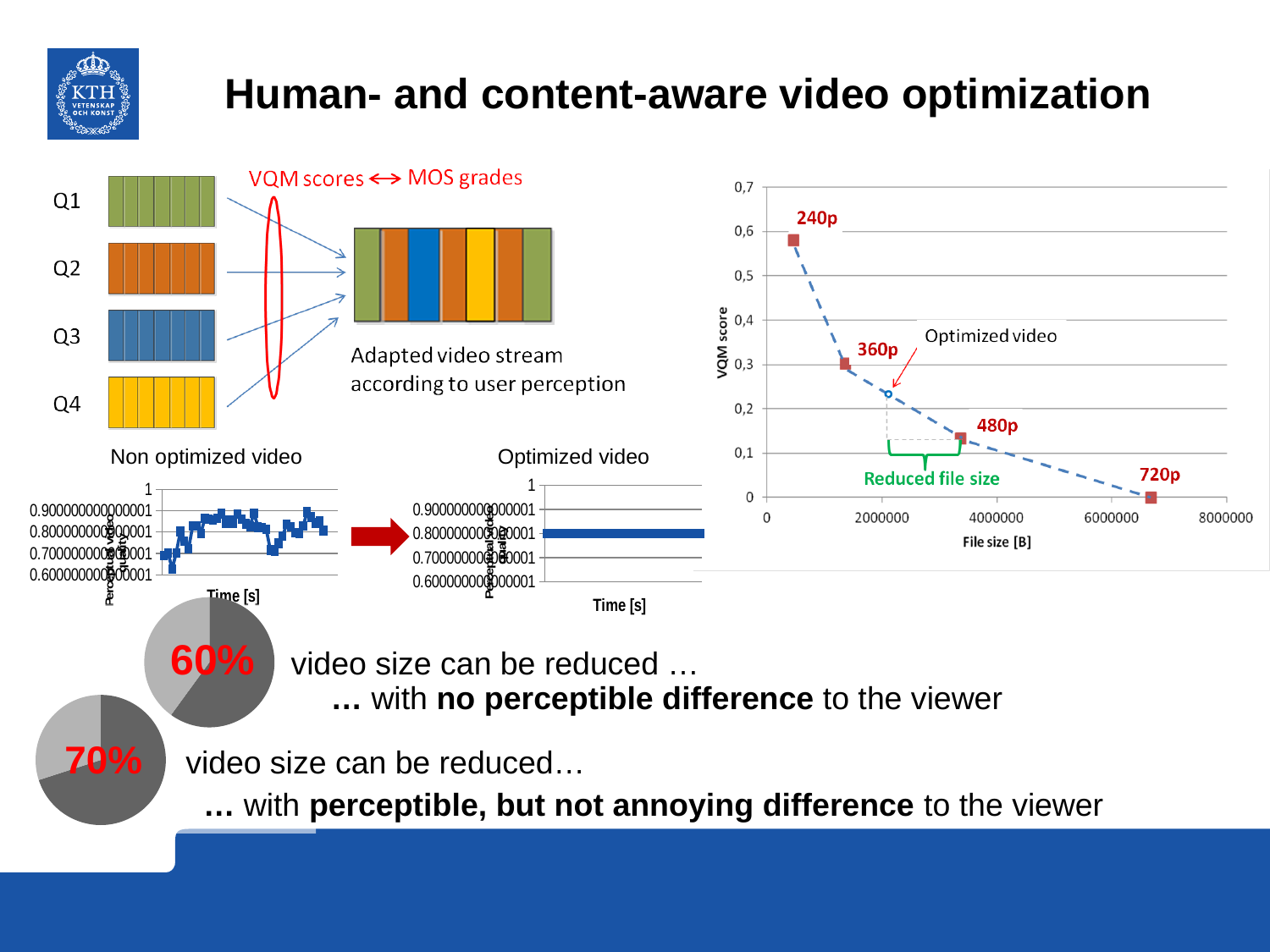
In the VQM score vs file size chart, is the VQM score for 240p greater or less than 0.5? greater In the VQM score vs file size chart, which labeled resolution has the highest VQM score? 240p What is the label of the x axis of the VQM score chart? File size [B] What percentage is shown on the upper pie chart next to 'video size can be reduced … with no perceptible difference'? 60% In the VQM score vs file size chart, does the VQM score rise or fall as file size increases? fall In the VQM score vs file size chart, which labeled resolution has the lowest VQM score? 720p In the VQM score vs file size chart, is the VQM score for 480p greater or less than 0.2? less In the VQM score vs file size chart, is the VQM score for 360p greater or less than 0.4? less What percentage is shown on the lower pie chart next to 'video size can be reduced… with perceptible, but not annoying difference'? 70% In the VQM score vs file size chart, which has a larger VQM score, 360p or 480p? 360p In the VQM score vs file size chart, how many resolution-labeled data points are plotted? 4 In the 'Optimized video' line chart, does the perceptual video quality vary or stay constant over time? stay constant